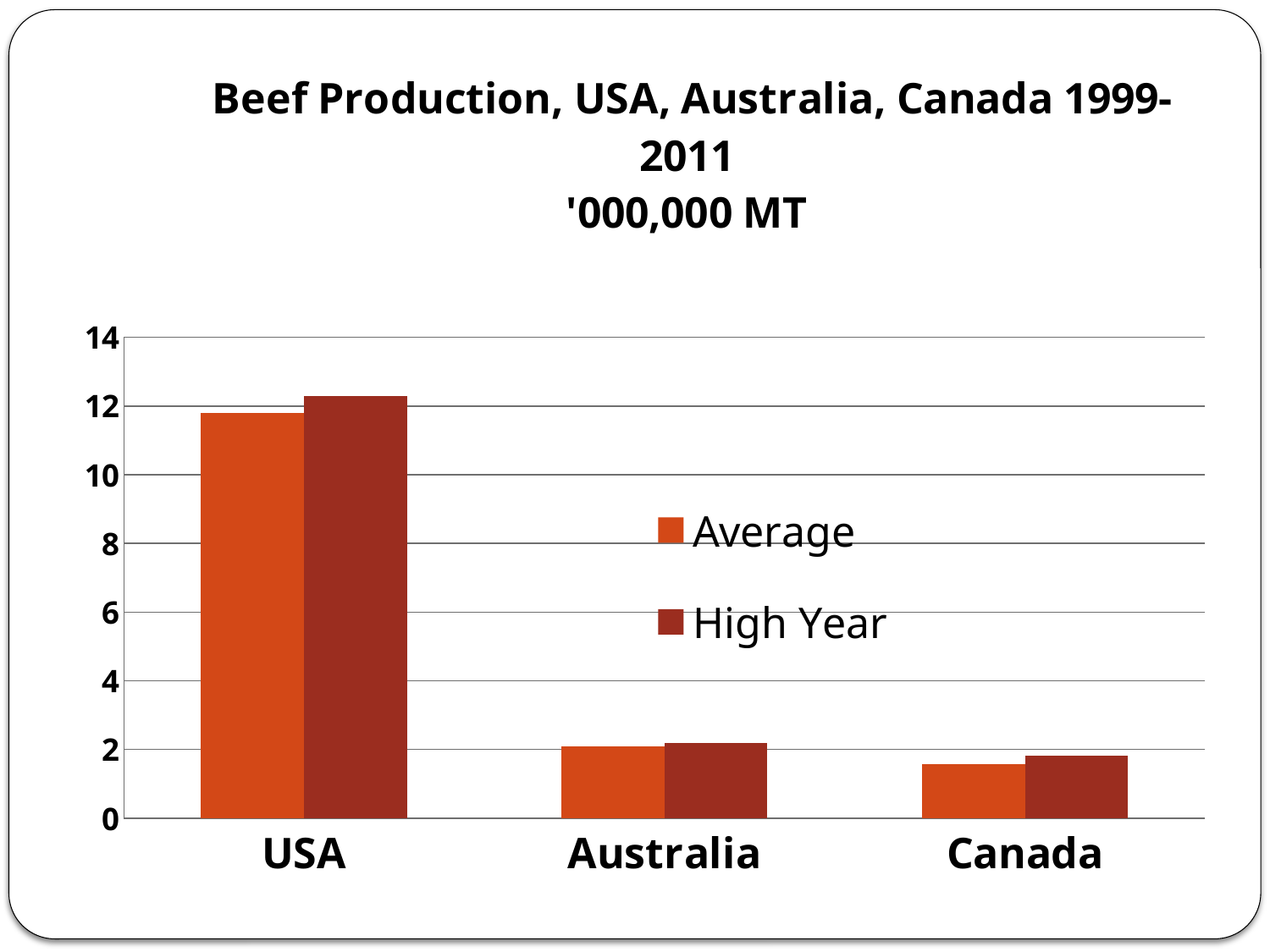
How many countries are shown on the x axis? 3 Is the Average value for Canada greater or less than 2? less Which country has the lowest High Year beef production? Canada Is the Average value for USA greater or less than 10? greater Which country has the lowest Average beef production? Canada Which country has the highest Average beef production? USA What kind of chart is shown on the slide? bar chart Is the Average value for Australia greater or less than 4? less Which is larger, the Average value for Australia or the Average value for Canada? Australia What unit is given in the chart title? '000,000 MT How many series does the legend list? 2 Which is larger, the High Year value for USA or the High Year value for Australia? USA